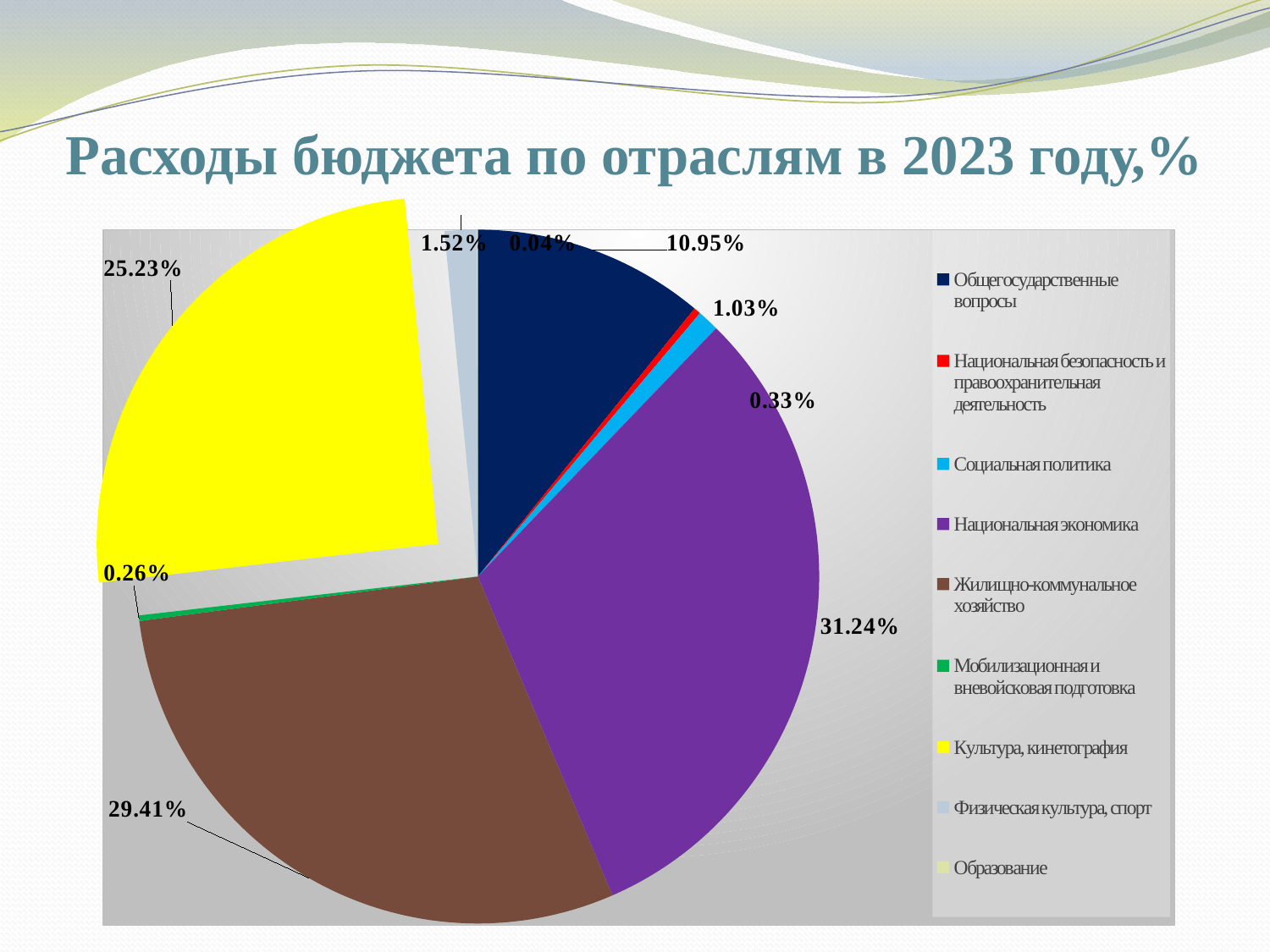
What is the chart's title? Расходы бюджета по отраслям в 2023 году,% What kind of chart is shown on the slide? pie chart What share of the budget goes to Жилищно-коммунальное хозяйство? 29.41% Which is larger, the share for Социальная политика or the share for Национальная безопасность и правоохранительная деятельность? Социальная политика Which category has the smallest share of the budget? Образование What share of the budget goes to Физическая культура, спорт? 1.52% What share of the budget goes to Общегосударственные вопросы? 10.95% What is the difference between the shares of Национальная экономика and Жилищно-коммунальное хозяйство? 1.83% What share of the budget goes to Национальная экономика? 31.24% Which category has the largest share of the budget? Национальная экономика How many categories does the legend list? 9 What share of the budget goes to Культура, кинетография? 25.23%